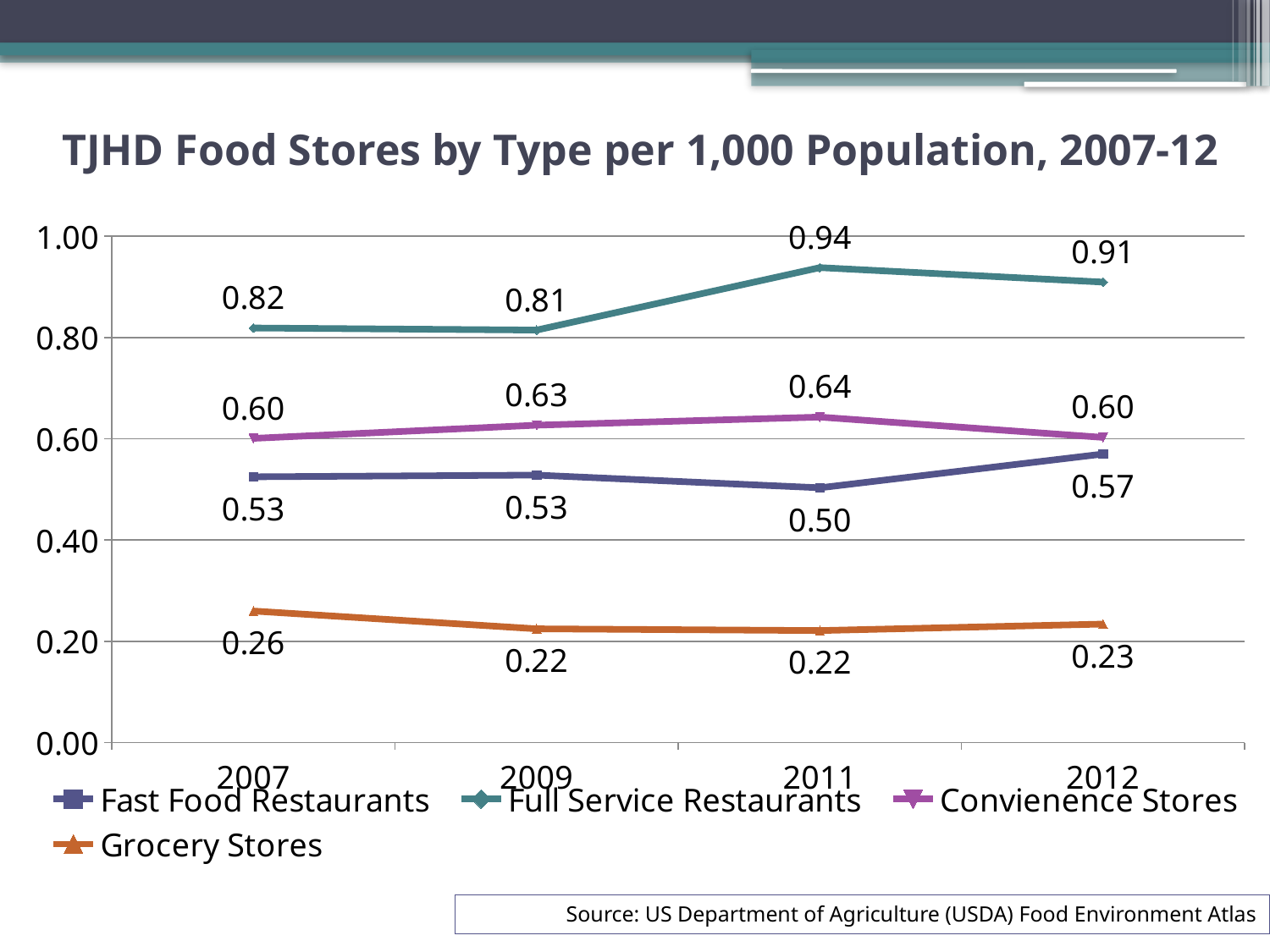
In which year is the Fast Food Restaurants value lowest? 2011 Which is larger in 2009: the Convienence Stores value or the Fast Food Restaurants value? Convienence Stores What is the value for Fast Food Restaurants in 2012? 0.57 What is the title of the chart? TJHD Food Stores by Type per 1,000 Population, 2007-12 What is the value for Full Service Restaurants in 2011? 0.94 In which year is the Full Service Restaurants value highest? 2011 What type of chart is shown on the slide? Line chart Does the Grocery Stores line rise or fall from 2007 to 2009? Fall What is the difference between the Full Service Restaurants value and the Fast Food Restaurants value in 2012? 0.34 What is the value for Grocery Stores in 2007? 0.26 How many series does the legend list? 4 How many years are plotted along the x axis? 4